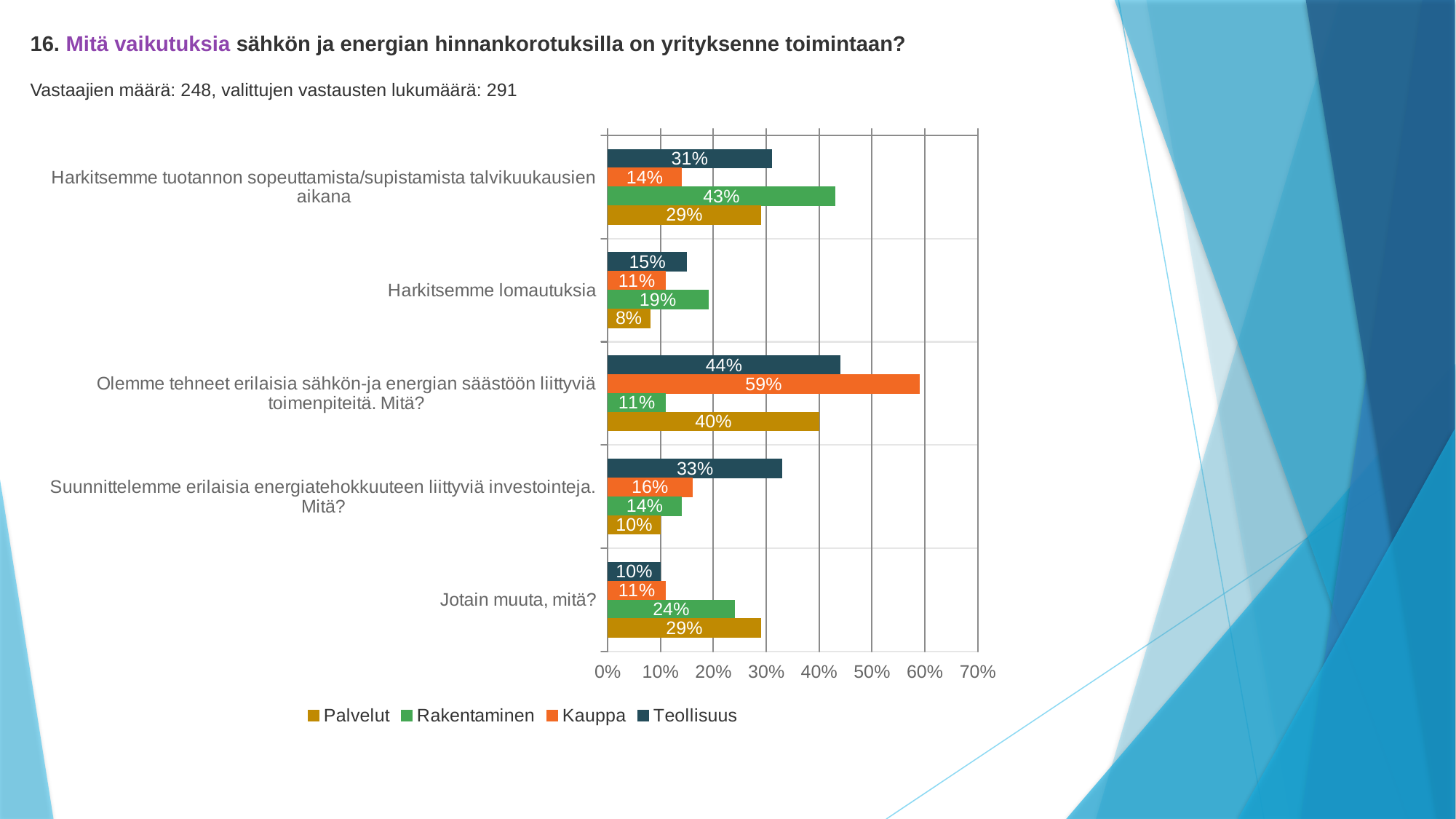
In the category "Harkitsemme lomautuksia", which is larger: the value for Rakentaminen or the value for Teollisuus? Rakentaminen What is the value for Rakentaminen in the category "Harkitsemme tuotannon sopeuttamista/supistamista talvikuukausien aikana"? 43% What is the value for Kauppa in the category "Olemme tehneet erilaisia sähkön-ja energian säästöön liittyviä toimenpiteitä. Mitä?"? 59% Which series has the highest value in the category "Jotain muuta, mitä?"? Palvelut What type of chart is shown on the slide? bar chart How many categories are shown on the chart? 5 Which series is shown in orange in the legend? Kauppa What is the value for Palvelut in the category "Harkitsemme lomautuksia"? 8% How many series does the legend list? 4 What is the value for Teollisuus in the category "Suunnittelemme erilaisia energiatehokkuuteen liittyviä investointeja. Mitä?"? 33% What is the difference between the Kauppa and Teollisuus values in the category "Olemme tehneet erilaisia sähkön-ja energian säästöön liittyviä toimenpiteitä. Mitä?"? 15% Which series has the lowest value in the category "Olemme tehneet erilaisia sähkön-ja energian säästöön liittyviä toimenpiteitä. Mitä?"? Rakentaminen